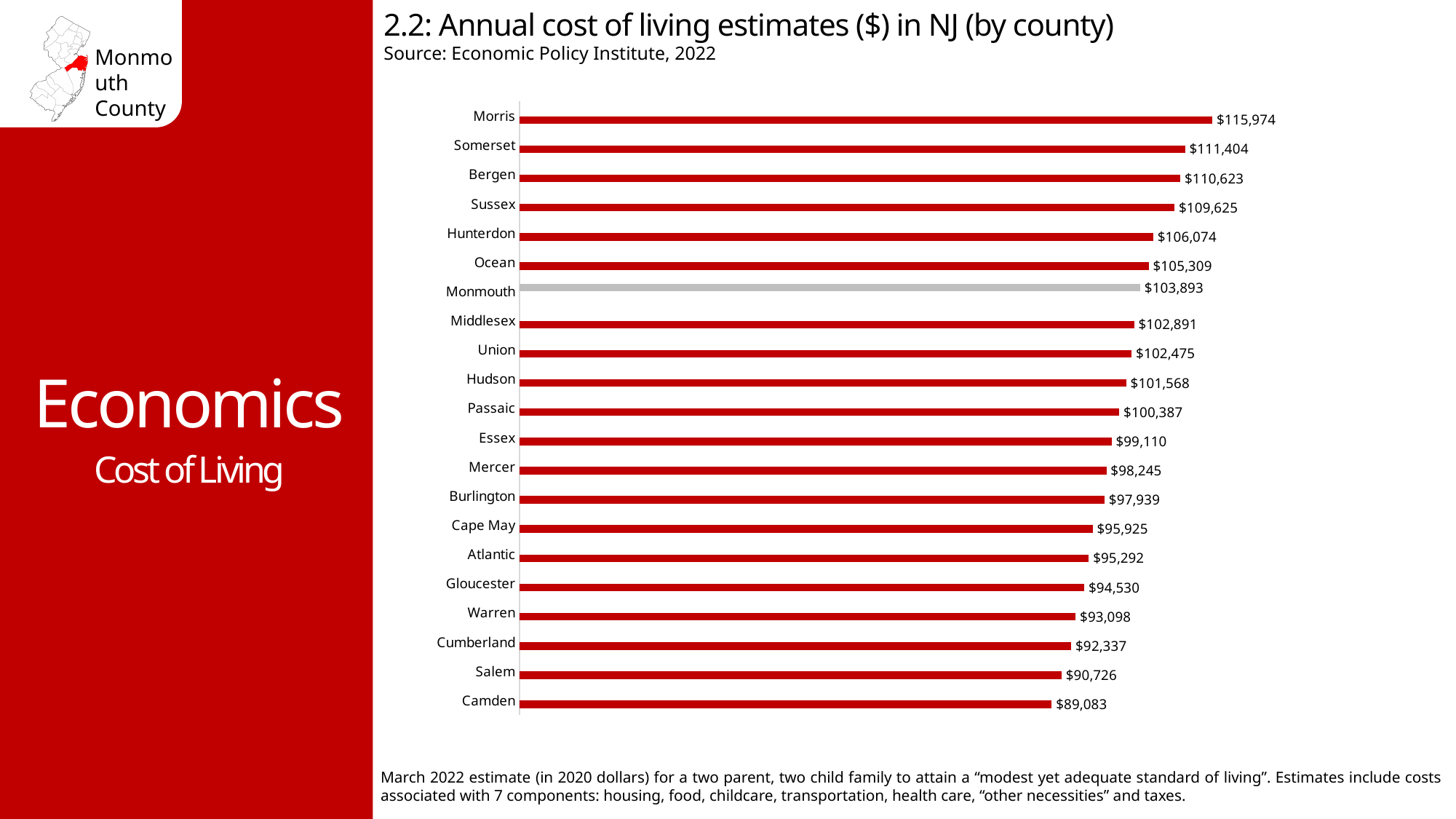
How many counties are shown in the chart? 21 What is the source cited for the chart? Economic Policy Institute, 2022 How much higher is Ocean County's cost of living estimate than Monmouth County's? $1,416 Which county has the lowest annual cost of living estimate? Camden What kind of chart is shown on the slide? Bar chart What is the difference between the cost of living estimates for Morris and Camden counties? $26,891 Which county has the highest annual cost of living estimate? Morris What is the annual cost of living estimate for Monmouth County? $103,893 Which county's bar is shown in grey rather than red? Monmouth What is the annual cost of living estimate for Cape May County? $95,925 Which county has a higher cost of living estimate, Hudson or Essex? Hudson What is the annual cost of living estimate for Bergen County? $110,623